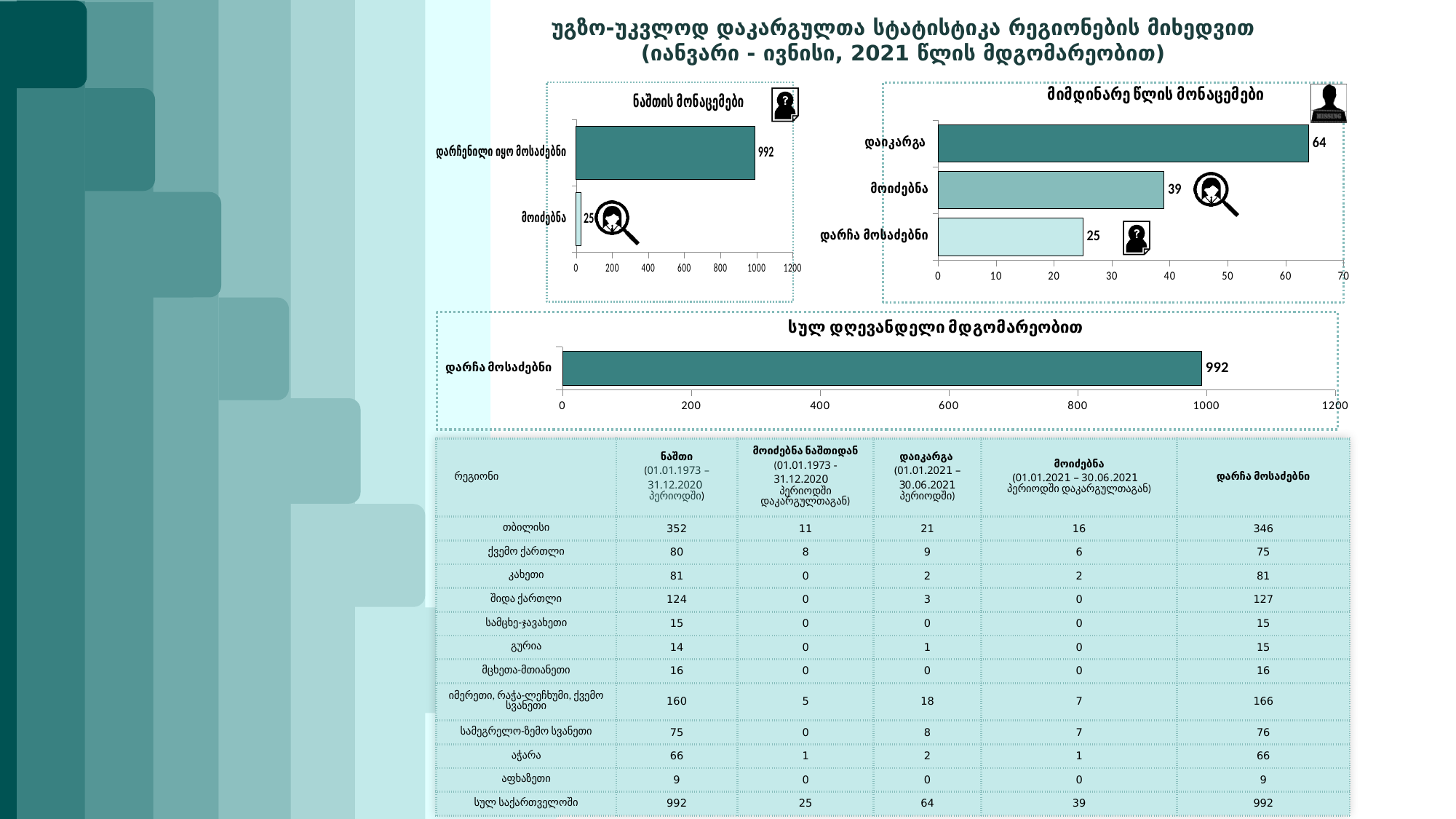
In the top-left chart titled "ნაშთის მონაცემები", what is the value for "დარჩენილი იყო მოსაძებნი"? 992 In the top-right chart titled "მიმდინარე წლის მონაცემები", what is the difference between "დაიკარგა" and "მოიძებნა"? 25 In the top-left chart titled "ნაშთის მონაცემები", what is the difference between the two bars? 967 In the bottom chart titled "სულ დღევანდელი მდგომარეობით", what is the value for "დარჩა მოსაძებნი"? 992 What kind of chart is the bottom chart titled "სულ დღევანდელი მდგომარეობით"? bar chart In the top-right chart titled "მიმდინარე წლის მონაცემები", which category has the highest value? დაიკარგა In the top-left chart titled "ნაშთის მონაცემები", is the value for "დარჩენილი იყო მოსაძებნი" greater or less than 800? greater In the top-right chart titled "მიმდინარე წლის მონაცემები", which category has the lowest value? დარჩა მოსაძებნი In the top-left chart titled "ნაშთის მონაცემები", what is the value for "მოიძებნა"? 25 In the top-right chart titled "მიმდინარე წლის მონაცემები", how many categories are plotted? 3 In the top-right chart titled "მიმდინარე წლის მონაცემები", what is the value for "დაიკარგა"? 64 In the top-right chart titled "მიმდინარე წლის მონაცემები", what is the value for "მოიძებნა"? 39